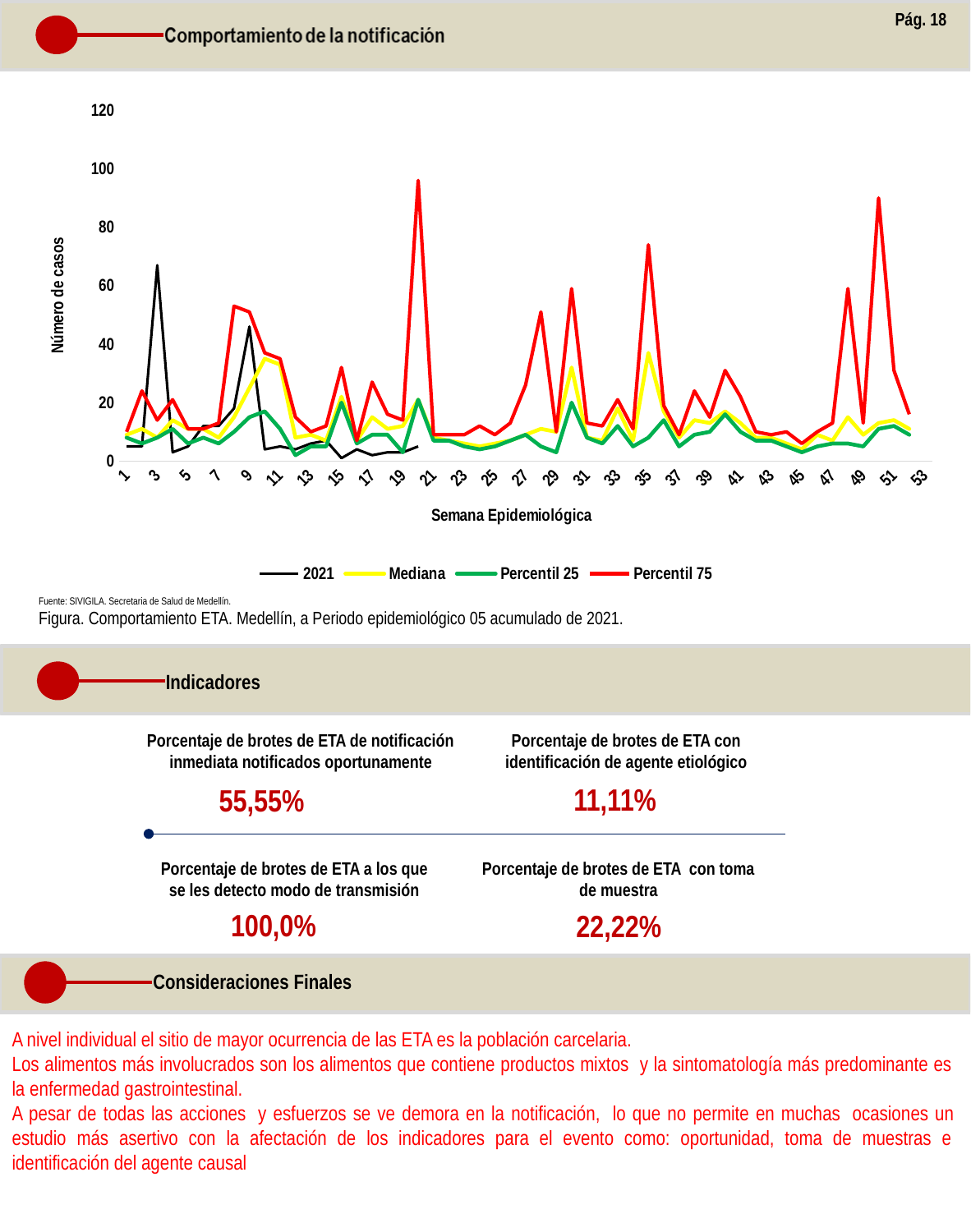
Is the value of the 2021 series at week 3 greater or less than 60? greater At week 20, which is larger: Percentil 75 or Percentil 25? Percentil 75 Does the 2021 line rise or fall between week 3 and week 5? fall What type of chart is shown on the slide? Line chart Is the value of Percentil 75 at week 20 greater or less than 80? greater Is the value of Percentil 75 at week 35 greater or less than 60? greater How many series does the legend of the chart list? 4 At week 3, which is larger: the 2021 value or the Percentil 75 value? 2021 Which series reaches the highest value anywhere on the chart? Percentil 75 What is the title of the x axis of the chart? Semana Epidemiológica In which epidemiological week does the 2021 line reach its highest value? 3 What is the title of the y axis of the chart? Número de casos